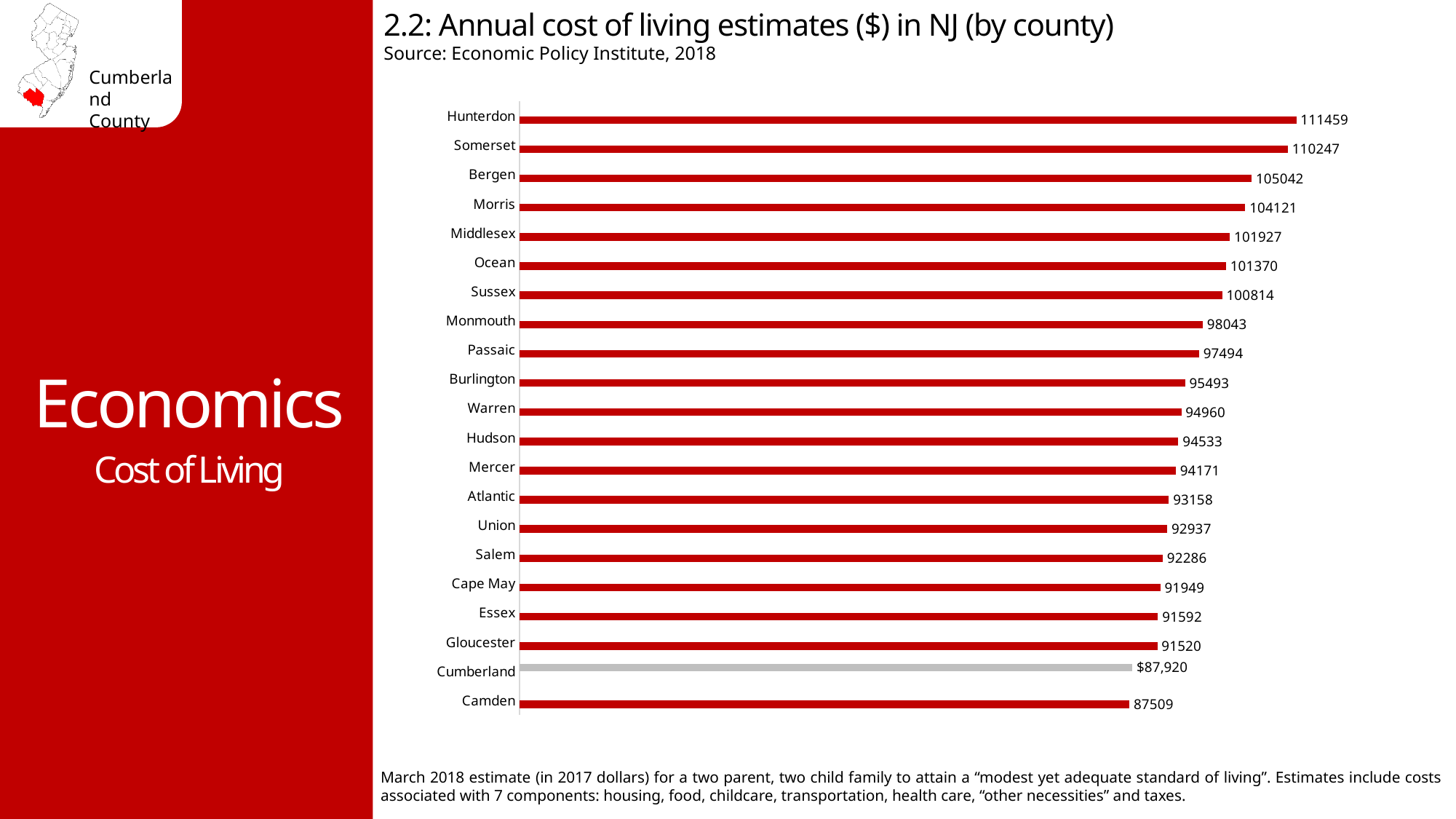
Which county has a higher cost of living estimate, Bergen or Ocean? Bergen What is the annual cost of living estimate for Hunterdon county? 111459 What is the annual cost of living estimate for Monmouth county? 98043 What is the difference between the cost of living estimates for Hunterdon and Camden? 23950 Which county has the highest annual cost of living estimate? Hunterdon Which county has the lowest annual cost of living estimate? Camden Which county's bar is coloured grey instead of red? Cumberland What is the annual cost of living estimate for Cumberland county? $87,920 What type of chart is shown on the slide? Bar chart Which county has a higher cost of living estimate, Cumberland or Camden? Cumberland What is the difference between the cost of living estimates for Hunterdon and Somerset? 1212 How many counties are shown in the chart? 21